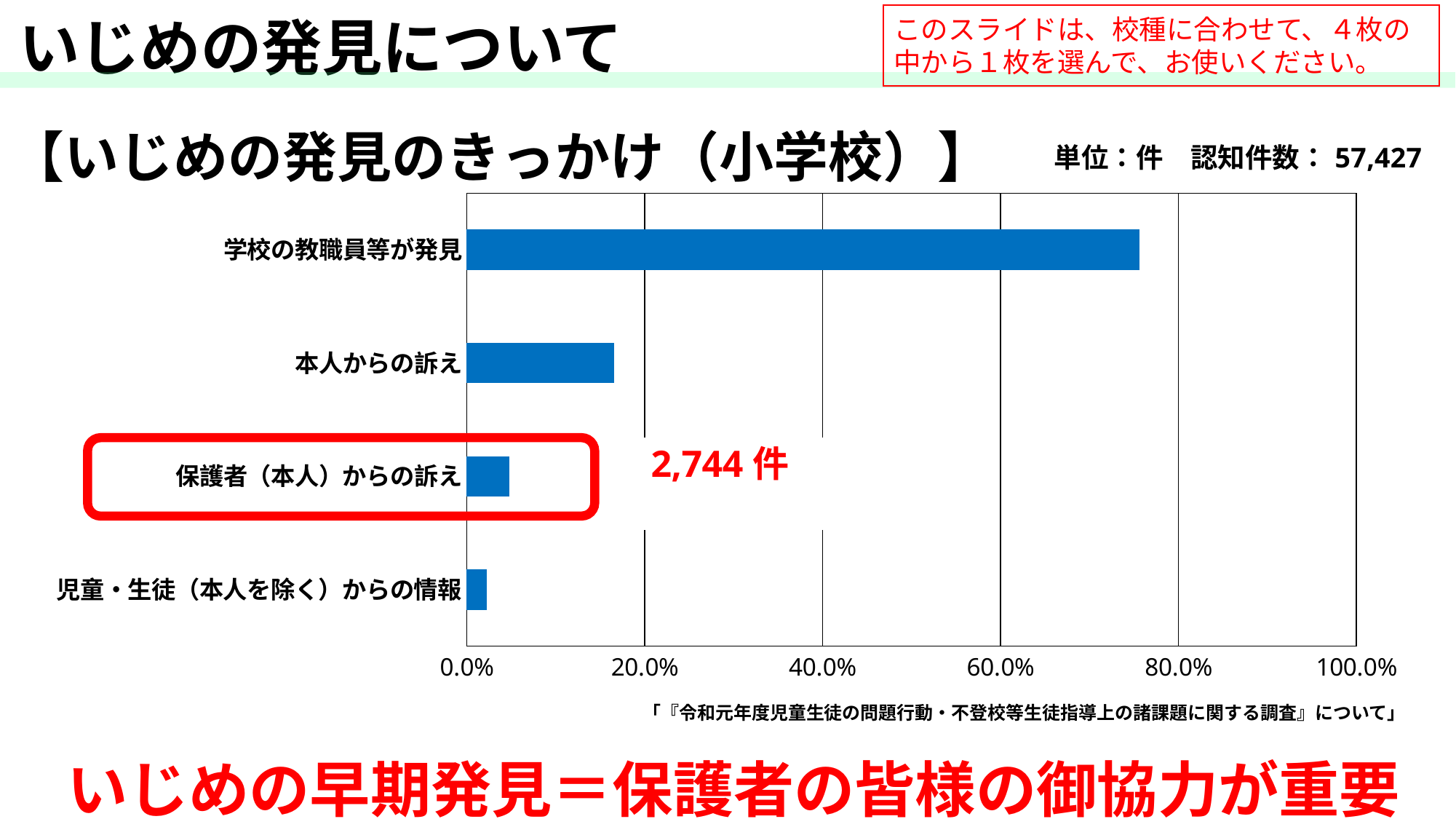
What kind of chart is shown on the slide? bar chart Which category has the highest value in the chart? 学校の教職員等が発見 What is the 認知件数 (total recognized cases) stated above the chart? 57,427 Which category has the lowest value in the chart? 児童・生徒（本人を除く）からの情報 Which is larger: the value for 本人からの訴え or the value for 保護者（本人）からの訴え? 本人からの訴え Is the value for 学校の教職員等が発見 greater or less than 80.0%? less Is the value for 本人からの訴え greater or less than 20.0%? less Is the value for 学校の教職員等が発見 greater or less than 60.0%? greater What is the title of the chart? いじめの発見のきっかけ（小学校） Which is larger: the value for 保護者（本人）からの訴え or the value for 児童・生徒（本人を除く）からの情報? 保護者（本人）からの訴え How many cases (件) are annotated for 保護者（本人）からの訴え? 2,744 件 How many categories are plotted in the chart? 4